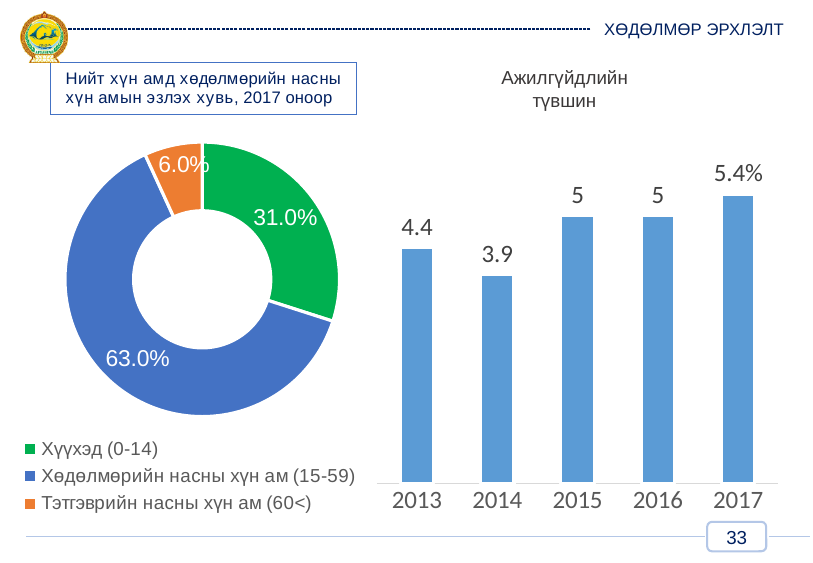
In the doughnut chart on the left, what share is shown for Хөдөлмөрийн насны хүн ам (15-59)? 63.0% What kind of chart is the 'Ажилгүйдлийн түвшин' chart? Bar chart In the doughnut chart on the left, what share is shown for Тэтгэврийн насны хүн ам (60<)? 6.0% In the doughnut chart on the left, which category has the largest share? Хөдөлмөрийн насны хүн ам (15-59) In the doughnut chart on the left, what share is shown for Хүүхэд (0-14)? 31.0% In the doughnut chart on the left, how many categories does the legend list? 3 In the doughnut chart on the left, which category has the smallest share? Тэтгэврийн насны хүн ам (60<) In the 'Ажилгүйдлийн түвшин' chart, what is the value for 2014? 3.9 In the 'Ажилгүйдлийн түвшин' chart, what is the difference between the values for 2013 and 2014? 0.5 In the 'Ажилгүйдлийн түвшин' chart, which year has the highest value? 2017 In the 'Ажилгүйдлийн түвшин' chart, what is the value for 2017? 5.4% In the 'Ажилгүйдлийн түвшин' chart, which year has the lowest value? 2014